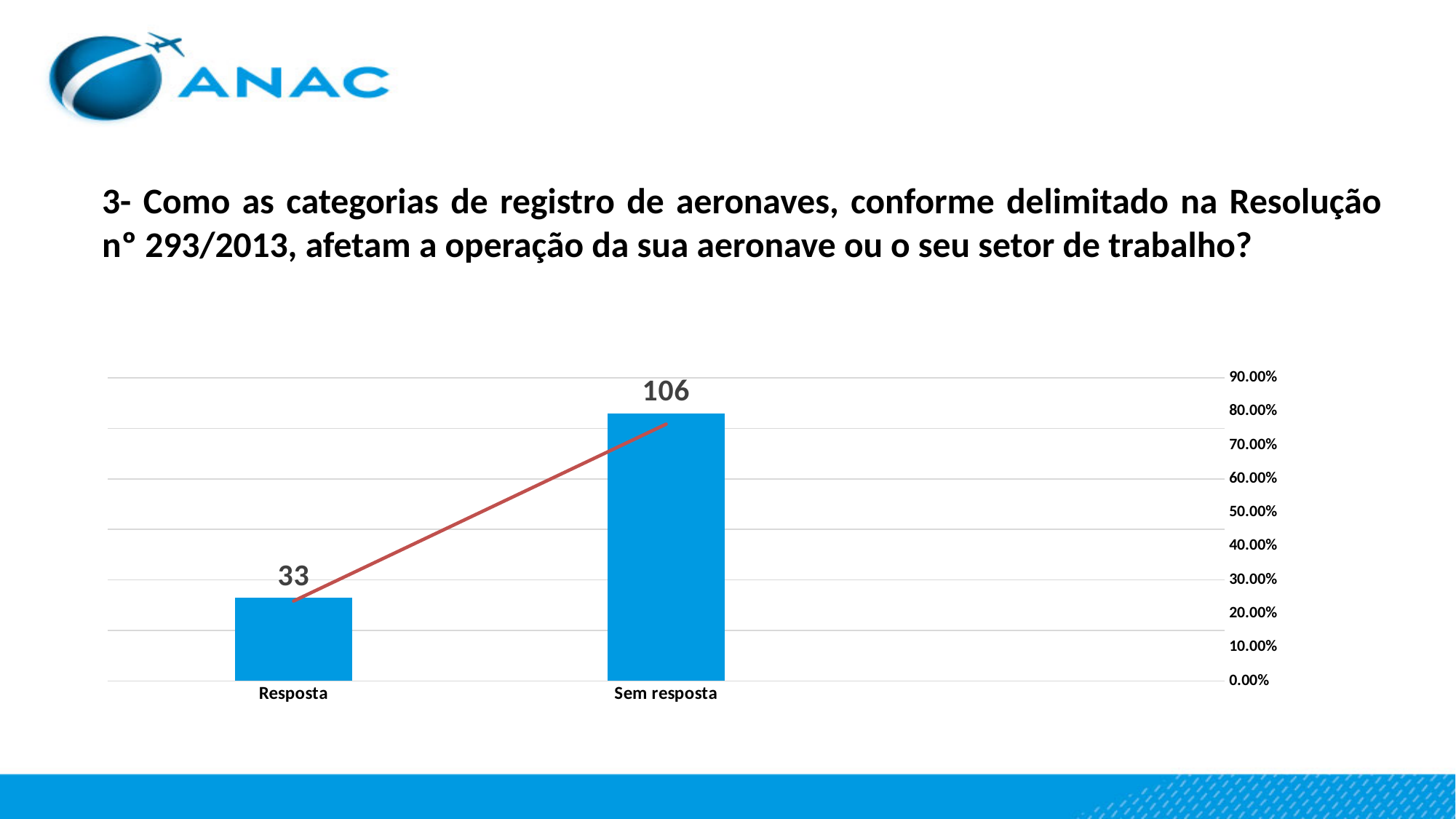
What kind of chart is shown on the slide? Combination bar and line chart Which is larger, the value for Resposta or the value for Sem resposta? Sem resposta What is the value shown for Sem resposta? 106 Is the red line's point at Resposta greater or less than 30.00% on the right-hand axis? less What colour are the bars in the chart? Blue Which category has the highest value? Sem resposta What is the difference between the values for Sem resposta and Resposta? 73 Is the red line's point at Sem resposta greater or less than 70.00% on the right-hand axis? greater What is the value shown for Resposta? 33 How many categories are shown on the x axis? 2 Do the values rise or fall from Resposta to Sem resposta? Rise Which category has the lowest value? Resposta